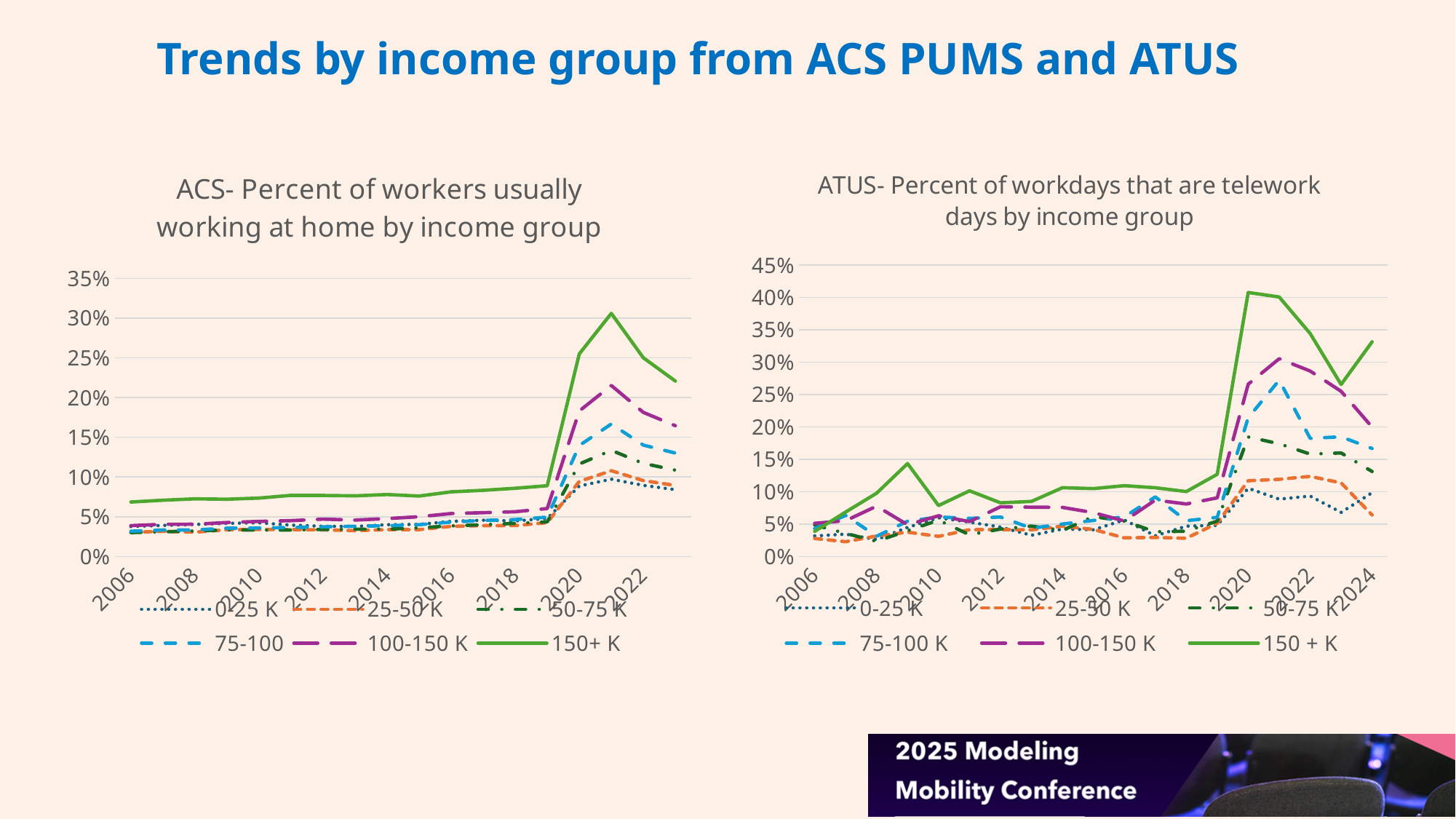
In the ATUS chart on the right, is the peak value for 150 + K around 2020 greater or less than 35%? greater How many series does the legend of the ATUS chart on the right list? 6 What kind of chart is the ACS chart on the left? Line chart In the ACS chart on the left, does the value for 150+ K rise or fall from 2006 to 2021? rise In the ATUS chart on the right, is the value for 25-50 K in 2024 greater or less than 10%? less In the ATUS chart on the right, which income group has the highest value in 2020? 150 + K What is the title of the chart on the right? ATUS- Percent of workdays that are telework days by income group In the ACS chart on the left, which is larger in 2022: the value for 150+ K or the value for 100-150 K? 150+ K In the ACS chart on the left, is the value for 0-25 K in 2006 greater or less than 5%? less In the ACS chart on the left, which income group has the highest value around 2021? 150+ K In the ATUS chart on the right, does the value for 150 + K rise or fall from 2021 to 2023? fall